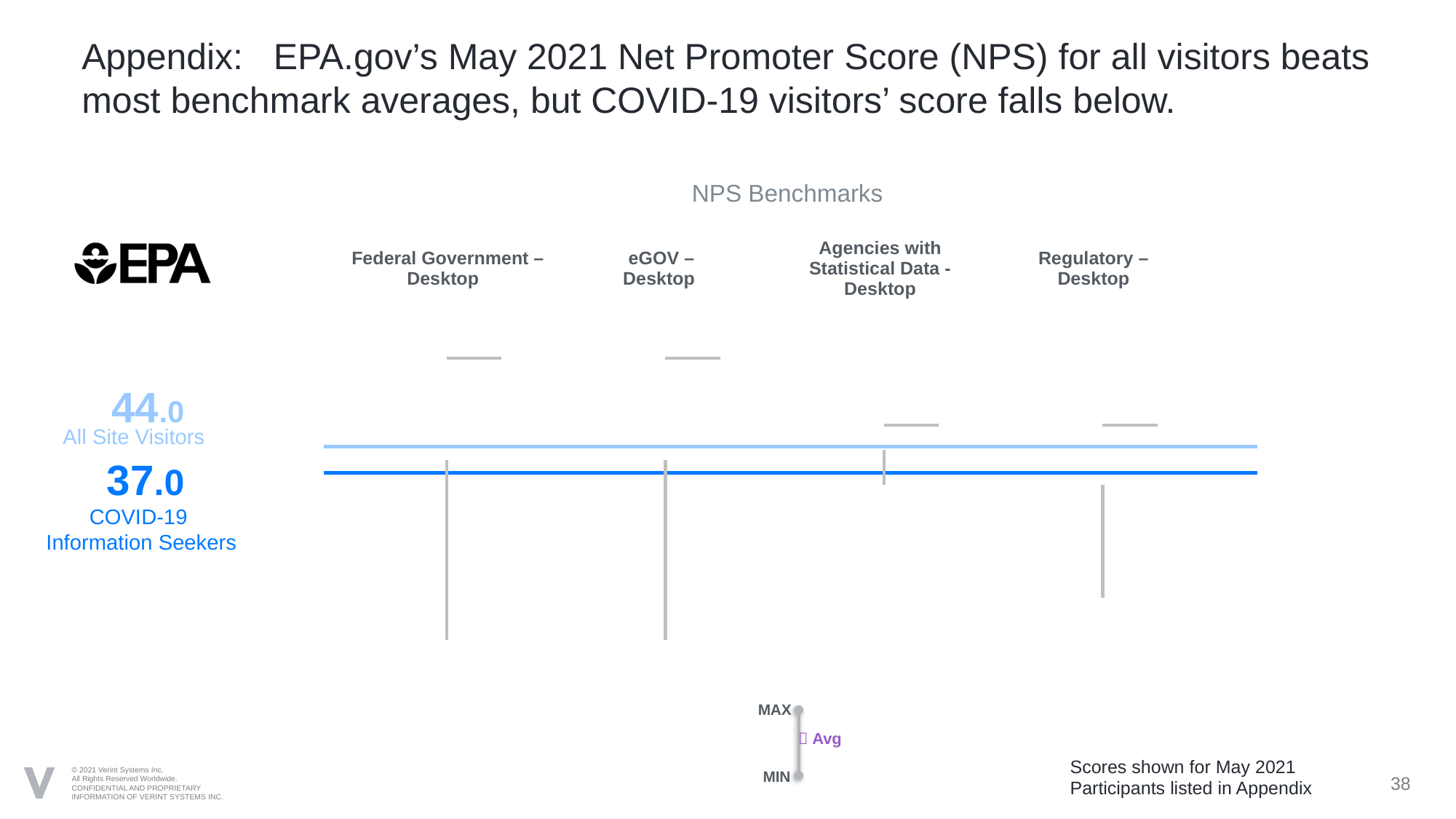
What three markers does the chart's legend explain for each benchmark range? MAX, Avg, MIN What is the May 2021 NPS for COVID-19 Information Seekers on EPA.gov? 37.0 Is the COVID-19 Information Seekers NPS greater or less than 40? less What is the difference between the All Site Visitors NPS and the COVID-19 Information Seekers NPS? 7.0 Which benchmark category has the narrowest range between its MAX and MIN? Agencies with Statistical Data - Desktop For which month are the NPS scores on the slide shown? May 2021 Which EPA.gov visitor group has the higher NPS, All Site Visitors or COVID-19 Information Seekers? All Site Visitors What is the May 2021 NPS for All Site Visitors on EPA.gov? 44.0 What is the title of the chart on the slide? NPS Benchmarks Is the MIN of the Regulatory – Desktop benchmark above or below the COVID-19 Information Seekers NPS line of 37.0? below How many NPS benchmark categories are shown on the chart? 4 Is the MAX of the Federal Government – Desktop benchmark above or below the All Site Visitors NPS line of 44.0? above